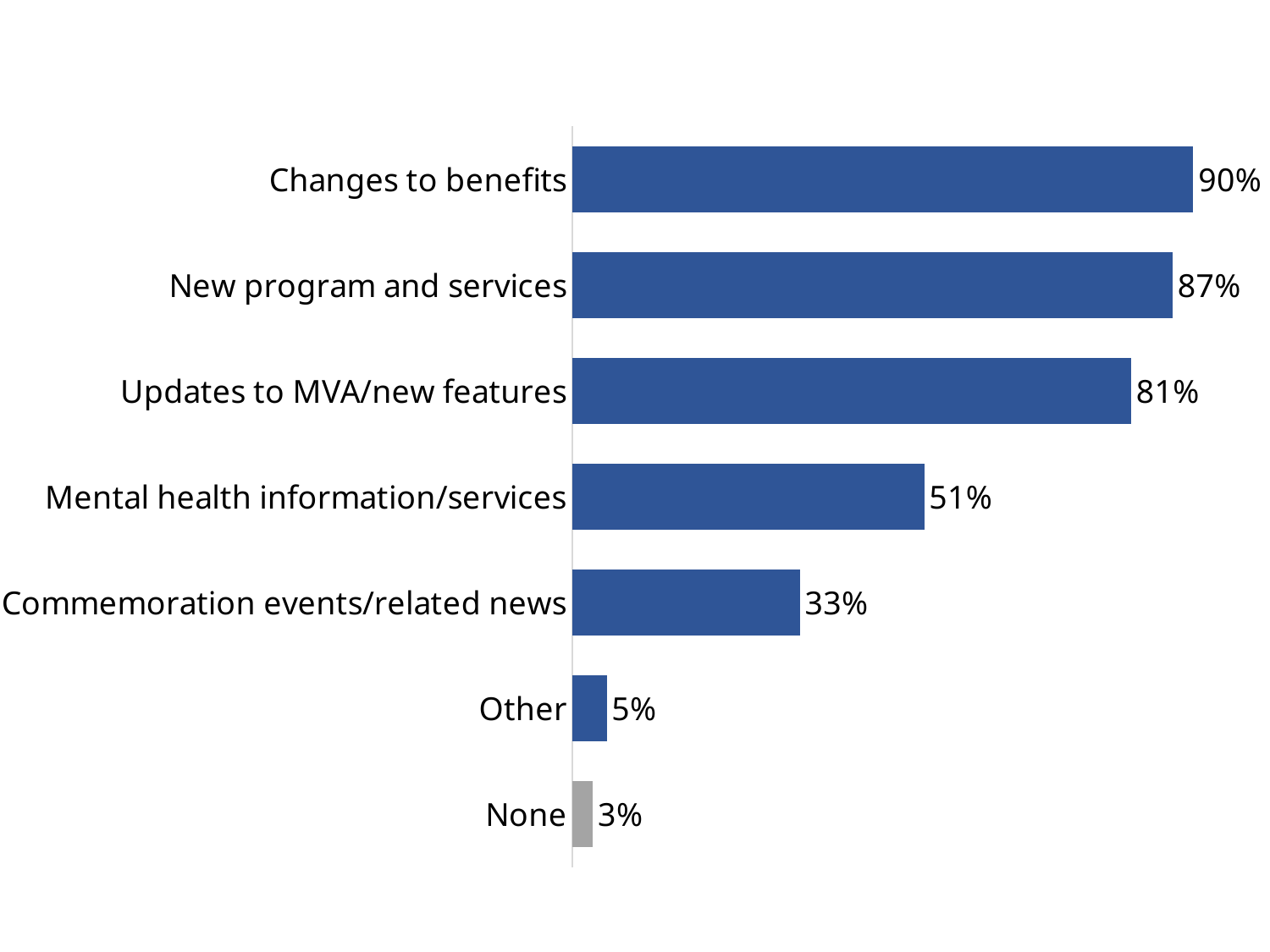
What is the value for None? 3% Which bar is coloured grey rather than blue? None What kind of chart is this? Bar chart What is the value for Commemoration events/related news? 33% Which category has the lowest value? None What is the value for Mental health information/services? 51% Which category has the highest value? Changes to benefits What is the difference between the values for Updates to MVA/new features and Mental health information/services? 30% How many categories are shown in the chart? 7 What is the value for Changes to benefits? 90% Which is larger, the value for Commemoration events/related news or the value for Other? Commemoration events/related news What is the difference between the values for Changes to benefits and New program and services? 3%